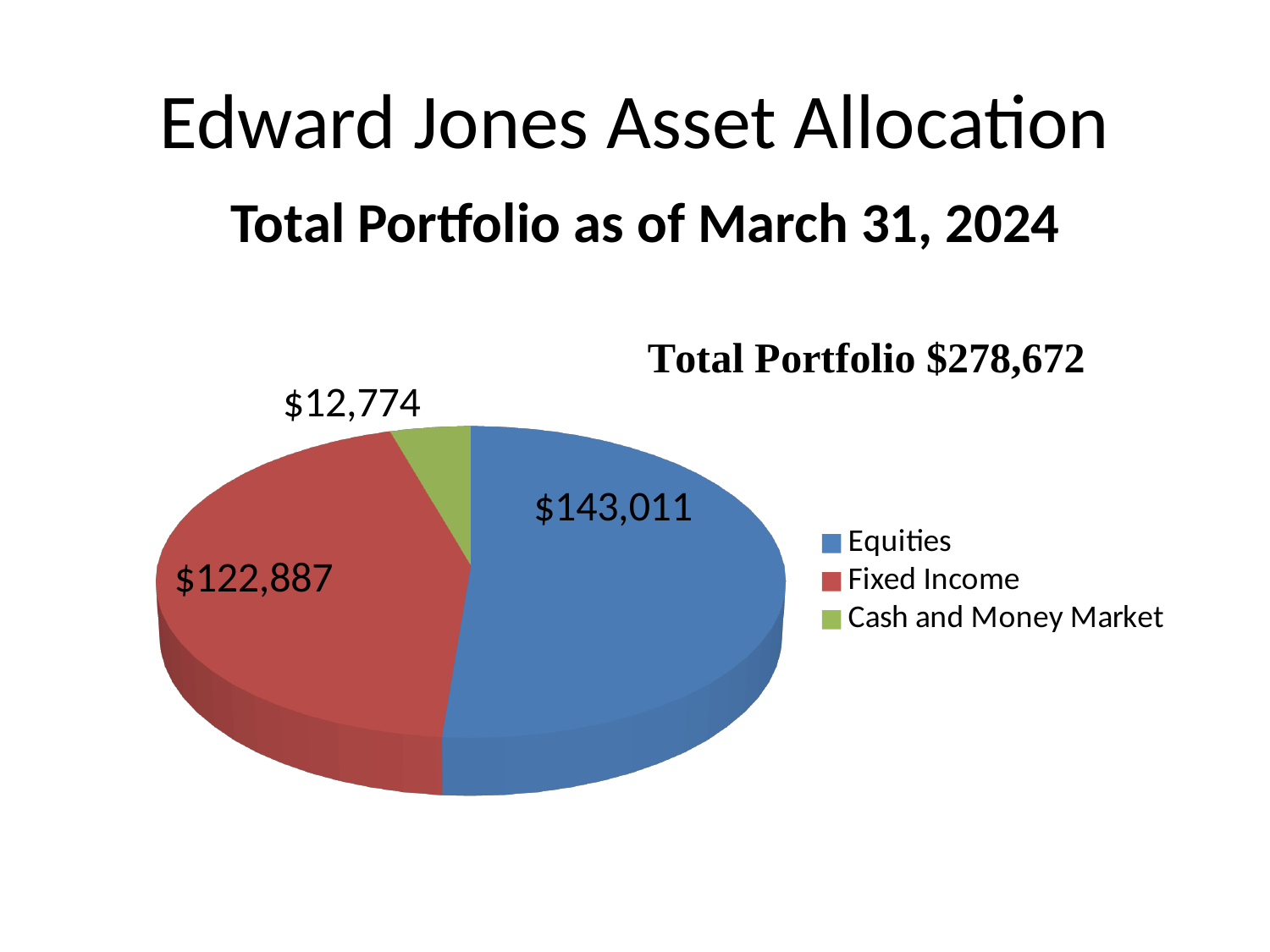
What colour is the Fixed Income slice? Red What type of chart is shown on the slide? Pie chart What is the value for Equities? $143,011 Which is larger, Fixed Income or Cash and Money Market? Fixed Income What is the difference between the Fixed Income value and the Cash and Money Market value? $110,113 What is the value for Cash and Money Market? $12,774 What is the difference between the Equities value and the Fixed Income value? $20,124 Which category has the smallest slice of the pie? Cash and Money Market What is the total of all slices in the pie chart? $278,672 What is the value for Fixed Income? $122,887 Which category has the largest slice of the pie? Equities How many categories does the pie chart have? 3